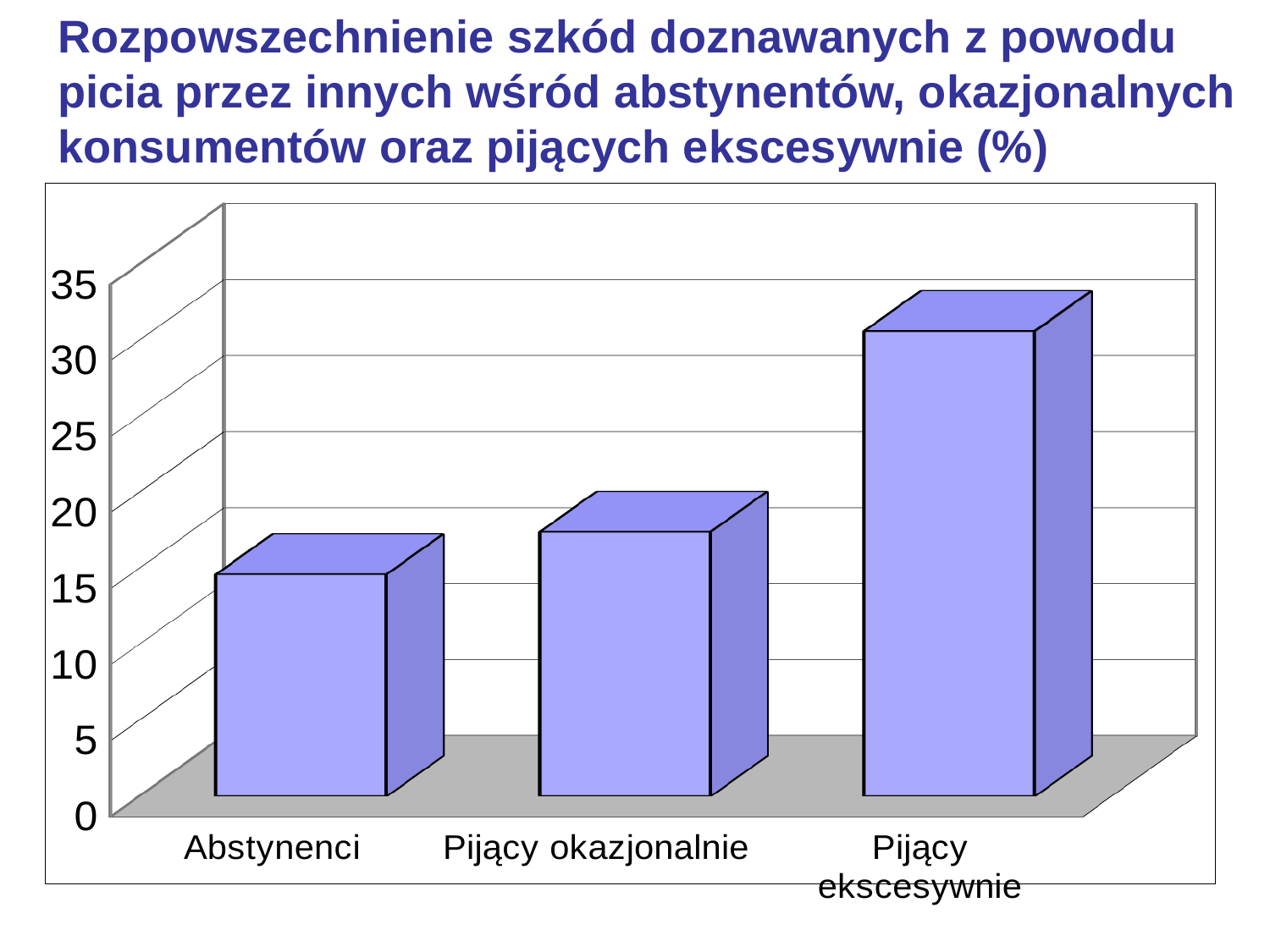
Is the value for Abstynenci greater or less than 10? greater Which category has the highest value in the chart? Pijący ekscesywnie Which is larger, the value for Pijący ekscesywnie or the value for Pijący okazjonalnie? Pijący ekscesywnie Is the value for Abstynenci greater or less than 20? less Do the values rise or fall from left to right across the categories? rise Which category has the lowest value in the chart? Abstynenci What is the highest value labelled on the vertical axis of the chart? 35 What kind of chart is shown on the slide? bar chart How many categories are shown on the x axis of the chart? 3 Which is larger, the value for Pijący okazjonalnie or the value for Abstynenci? Pijący okazjonalnie Is the value for Pijący ekscesywnie greater or less than 25? greater